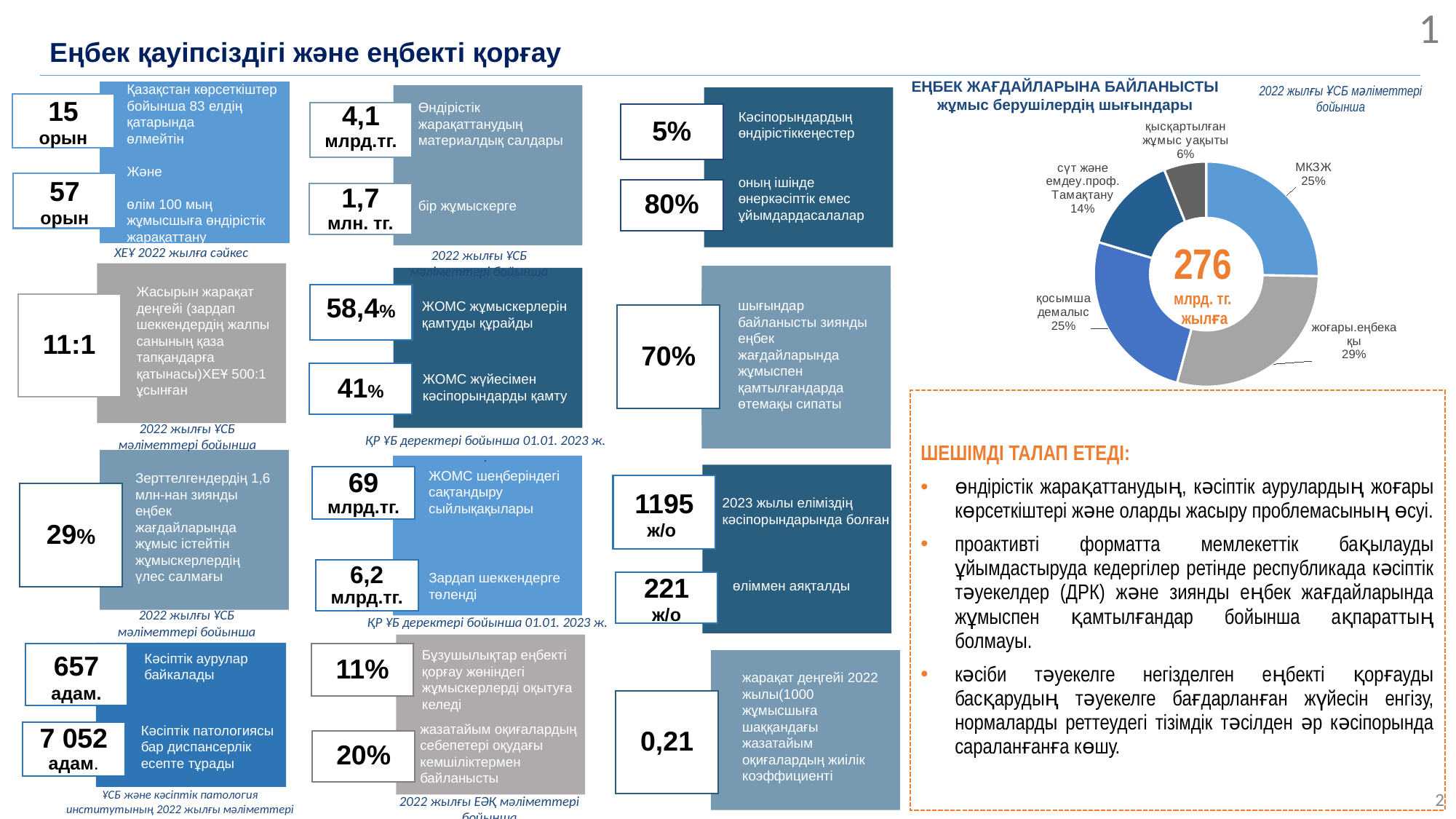
What is the share for 'МКЗЖ' in the doughnut chart? 25% Which category has the smallest share in the doughnut chart? қысқартылған жұмыс уақыты What is the share for 'қосымша демалыс' in the doughnut chart? 25% What is the difference in percentage points between 'жоғары.еңбекақы' and 'сүт және емдеу.проф. Тамақтану' in the doughnut chart? 15 What is the share for 'қысқартылған жұмыс уақыты' in the doughnut chart? 6% Which is larger in the doughnut chart: 'сүт және емдеу.проф. Тамақтану' or 'қысқартылған жұмыс уақыты'? сүт және емдеу.проф. Тамақтану What total value is printed in the centre of the doughnut chart? 276 млрд. тг. жылға How many categories are shown in the doughnut chart? 5 What is the share for 'сүт және емдеу.проф. Тамақтану' in the doughnut chart? 14% What is the share for 'жоғары.еңбекақы' in the doughnut chart? 29% Which category has the largest share in the doughnut chart? жоғары.еңбекақы What kind of chart is shown on the slide? doughnut chart